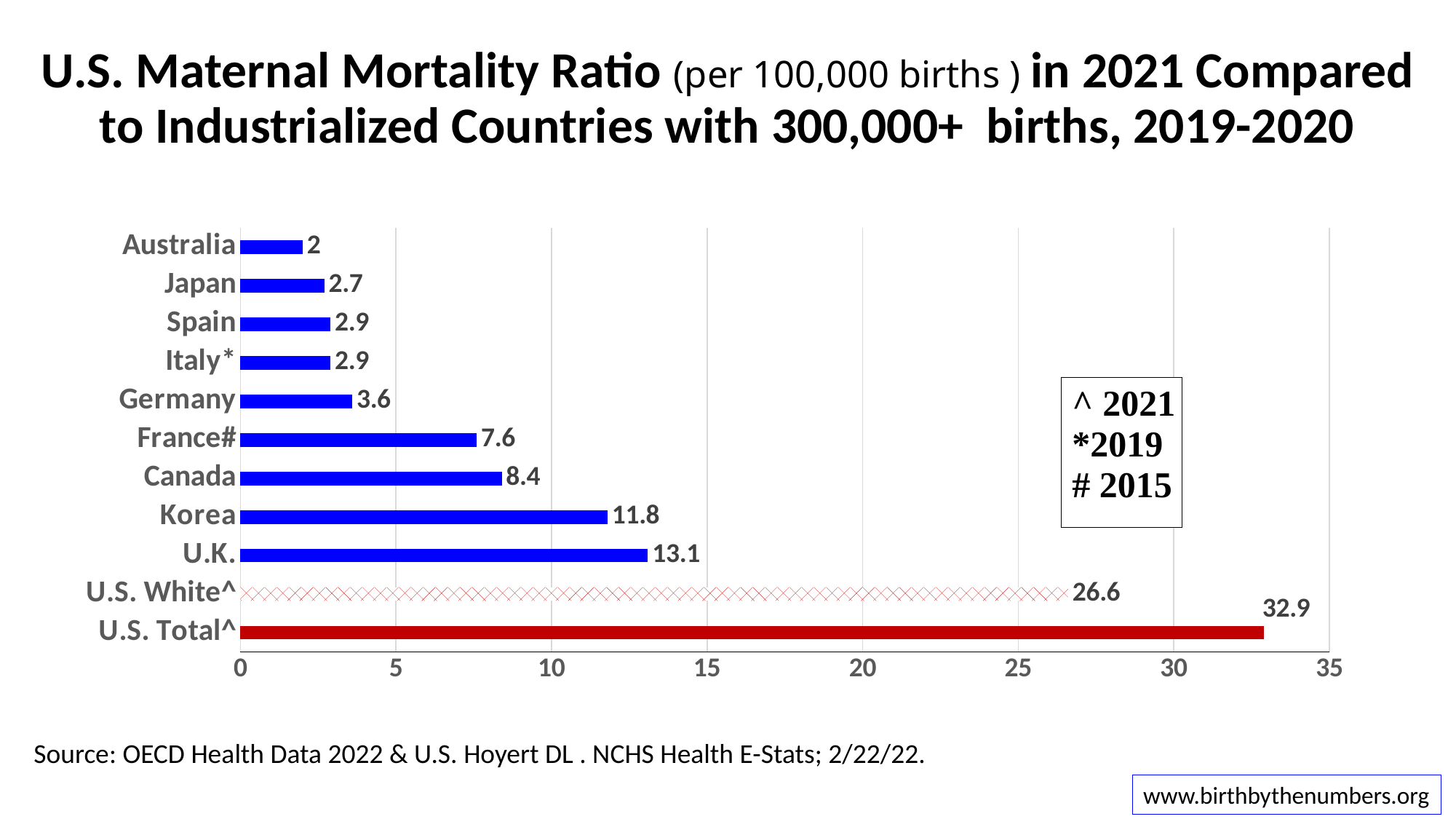
Which category has the highest maternal mortality ratio on the chart? U.S. Total^ Which has a larger value, France# or Canada? Canada What kind of chart is shown on the slide? bar chart Which category has the lowest maternal mortality ratio on the chart? Australia What is the difference between the values for U.S. Total^ and U.S. White^? 6.3 How many categories are plotted on the chart? 11 What is the value shown for U.S. White^? 26.6 What is the value shown for Korea? 11.8 Is the value for U.S. Total^ greater or less than 30? greater What is the difference between the values for U.K. and Germany? 9.5 What is the maternal mortality ratio shown for Canada? 8.4 What is the maximum value shown on the x axis? 35